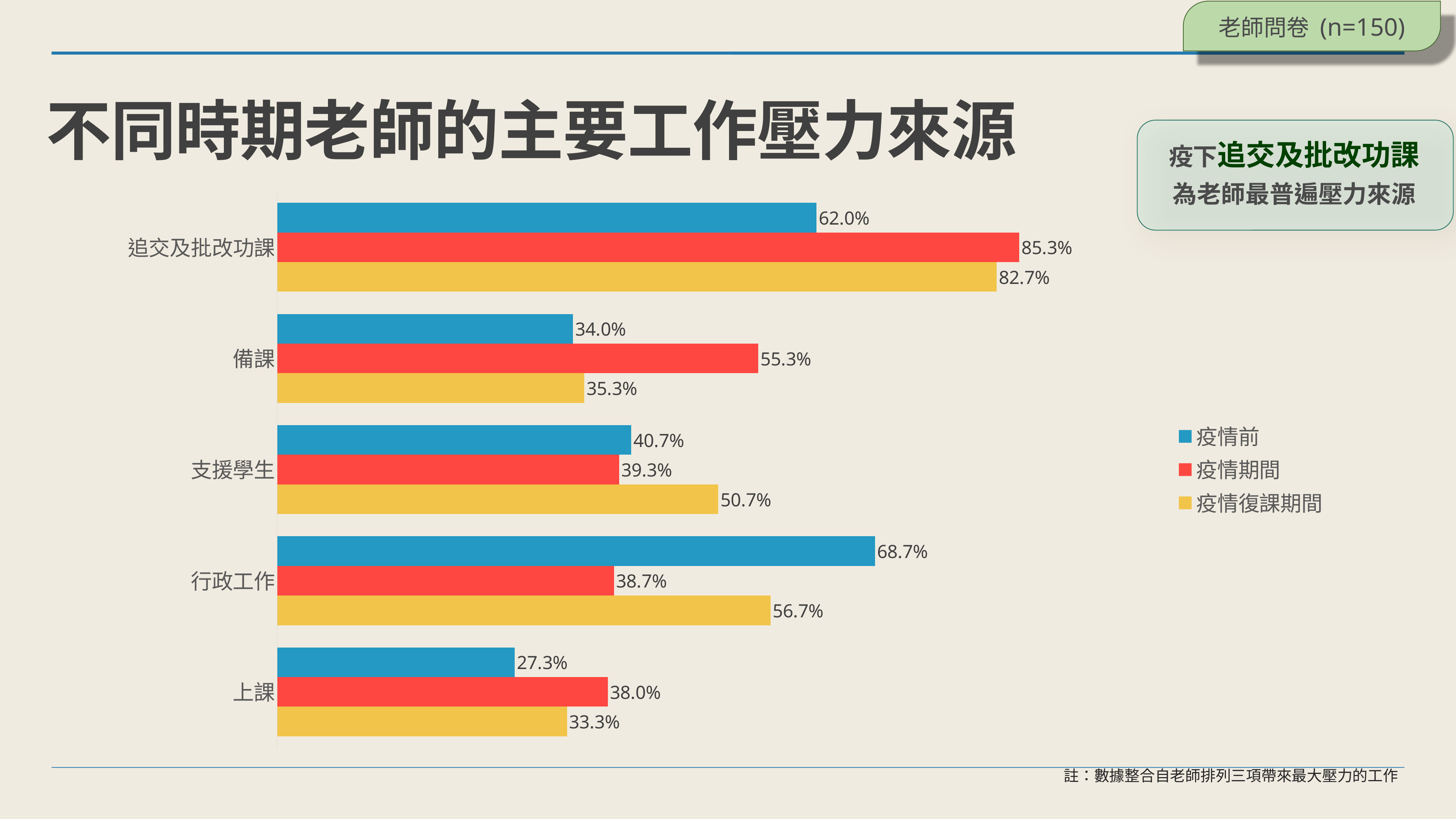
What is the value for 支援學生 in the 疫情復課期間 series? 50.7% What kind of chart is shown on the slide? Bar chart What is the difference between the 疫情期間 and 疫情復課期間 values for 追交及批改功課? 2.6% Which colour represents the 疫情期間 series? Red What is the value for 行政工作 in the 疫情前 series? 68.7% How many categories are shown on the chart? 5 Which category has the highest value in the 疫情前 series? 行政工作 Which category has the lowest value in the 疫情復課期間 series? 上課 For 行政工作, which is larger: the 疫情前 value or the 疫情期間 value? 疫情前 What is the value for 追交及批改功課 in the 疫情期間 series? 85.3% What is the difference between the 疫情期間 and 疫情前 values for 備課? 21.3% How many series does the legend list? 3